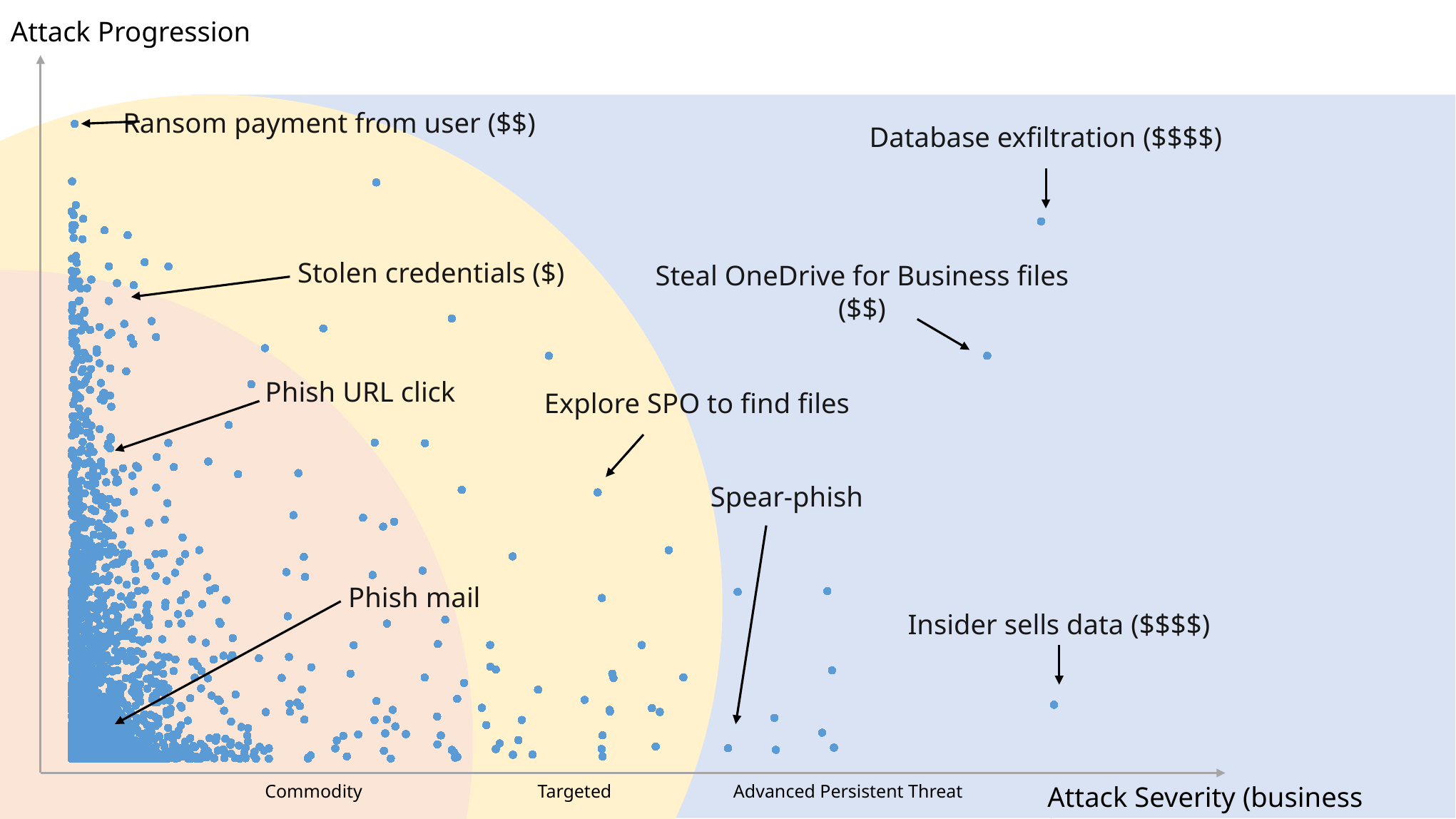
Which horizontal-axis category does the Spear-phish point fall under? Advanced Persistent Threat Which annotated point is furthest to the right on the Attack Severity axis? Insider sells data ($$$$) How many annotated (labelled) attack points are there on the chart? 9 What kind of chart is shown on the slide? scatter chart What dollar-sign cost label is shown for Stolen credentials? $ What is the label on the vertical axis of the chart? Attack Progression Which horizontal-axis category is furthest to the right? Advanced Persistent Threat Which is higher on the Attack Progression axis: Ransom payment from user or Phish mail? Ransom payment from user Which is higher on the Attack Progression axis: Database exfiltration or Insider sells data? Database exfiltration Which annotated point is highest on the Attack Progression axis? Ransom payment from user ($$) How many severity categories are labelled along the horizontal axis? 3 Which is further right on the Attack Severity axis: Database exfiltration or Phish mail? Database exfiltration